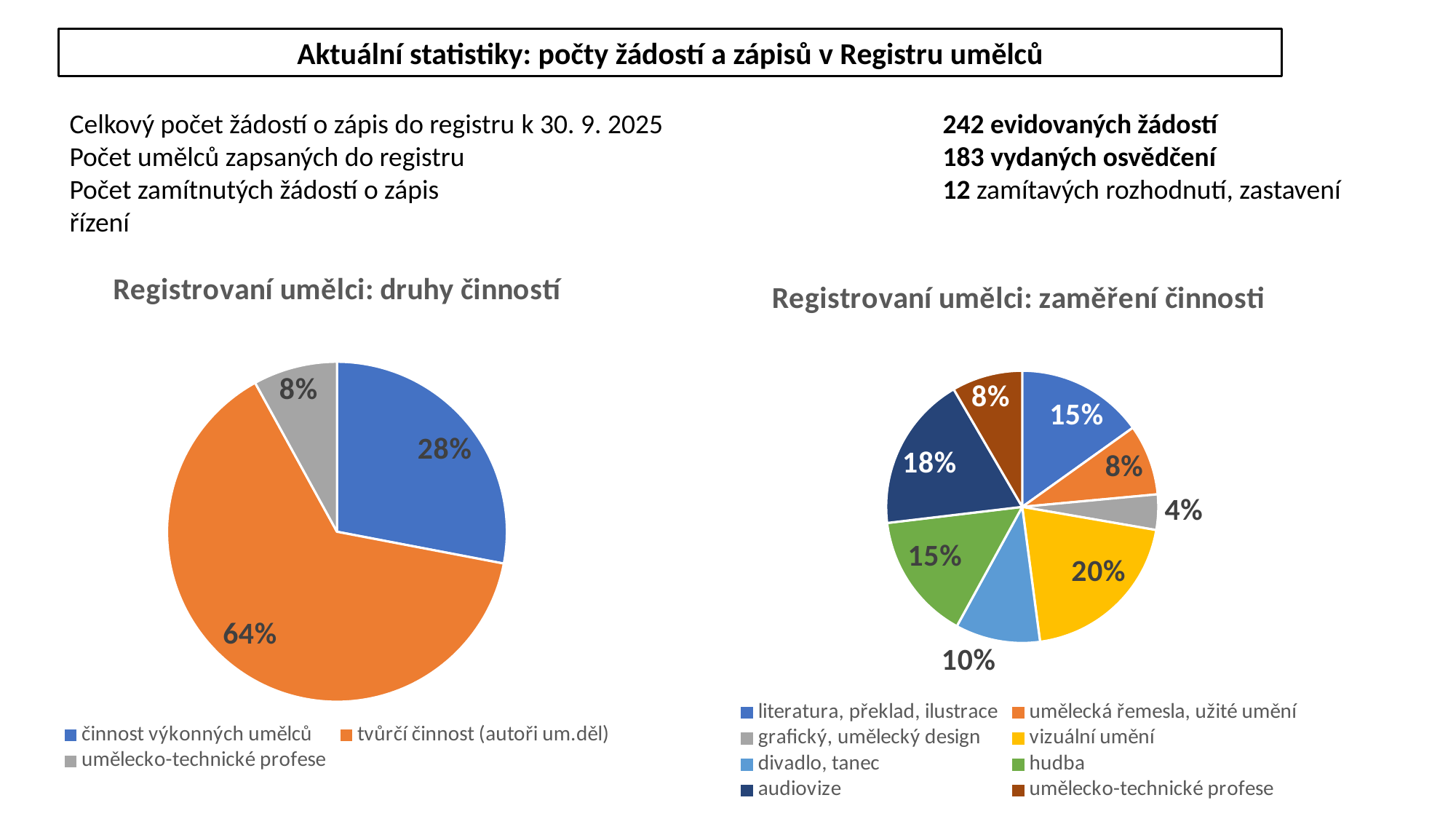
How many categories does the chart 'Registrovaní umělci: druhy činností' show? 3 In the chart 'Registrovaní umělci: zaměření činnosti', which is larger: 'divadlo, tanec' or 'hudba'? hudba In the chart 'Registrovaní umělci: zaměření činnosti', what share does 'vizuální umění' have? 20% In the chart 'Registrovaní umělci: druhy činností', what is the difference in percentage points between 'tvůrčí činnost (autoři um.děl)' and 'činnost výkonných umělců'? 36 percentage points In the chart 'Registrovaní umělci: zaměření činnosti', which category has the smallest share? grafický, umělecký design In the chart 'Registrovaní umělci: druhy činností', which category has the smallest share? umělecko-technické profese In the chart 'Registrovaní umělci: druhy činností', what share does 'tvůrčí činnost (autoři um.děl)' have? 64% In the chart 'Registrovaní umělci: zaměření činnosti', what share does 'audiovize' have? 18% How many categories does the legend of the chart 'Registrovaní umělci: zaměření činnosti' list? 8 In the chart 'Registrovaní umělci: zaměření činnosti', which category has the largest share? vizuální umění What kind of chart is 'Registrovaní umělci: zaměření činnosti'? pie chart